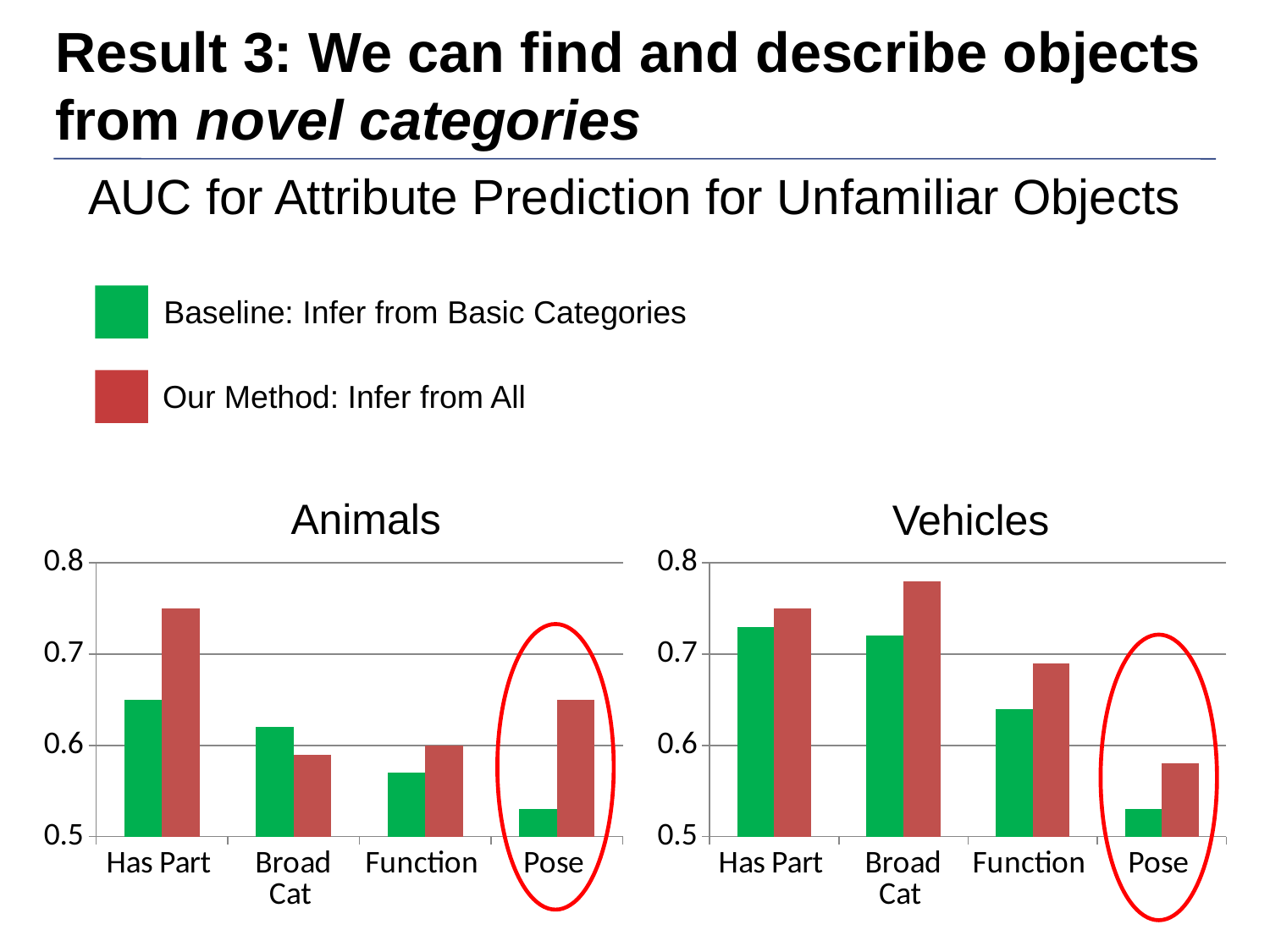
What kind of chart is the Animals chart? bar chart In the Animals chart, which category has the highest value for Our Method: Infer from All? Has Part In the Animals chart, which series has the larger value for Broad Cat? Baseline: Infer from Basic Categories Which category is circled in red on both charts? Pose In the Vehicles chart, which series has the larger value for Function? Our Method: Infer from All In the Vehicles chart, is the value for Our Method: Infer from All at Pose greater or less than 0.6? less In the Animals chart, is the value for Our Method: Infer from All at Has Part greater or less than 0.7? greater In the Vehicles chart, which category has the highest value for Our Method: Infer from All? Broad Cat How many series does the legend list? 2 How many categories are shown on the x axis of the Vehicles chart? 4 In the Animals chart, which category has the lowest value for Baseline: Infer from Basic Categories? Pose In the Vehicles chart, which category has the lowest value for Baseline: Infer from Basic Categories? Pose